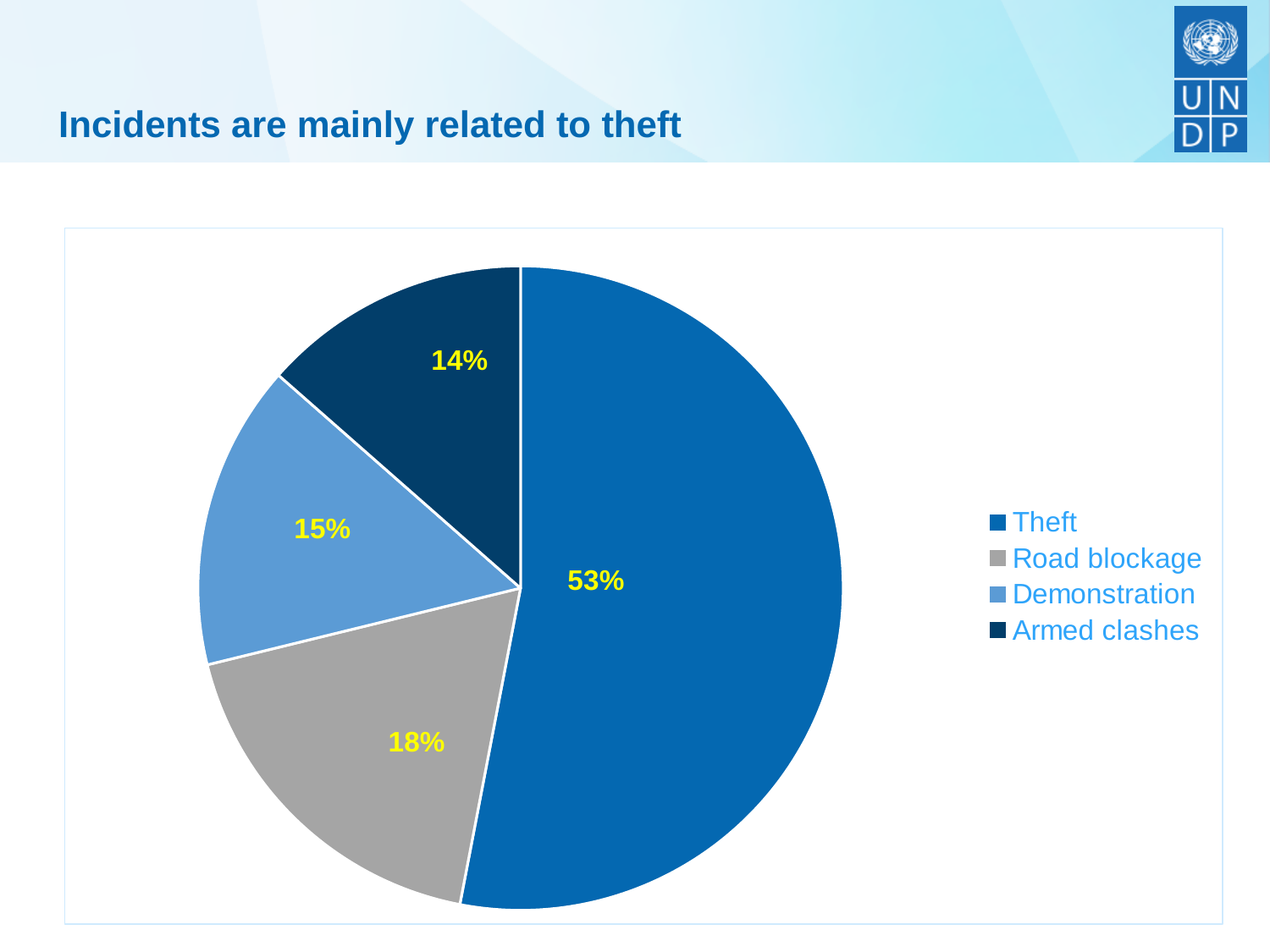
What share of incidents is Armed clashes? 14% Which category has the smallest share of the pie? Armed clashes What share of incidents is Theft? 53% Which is larger, the share for Road blockage or the share for Demonstration? Road blockage What share of incidents is Demonstration? 15% Which category is shown in the darkest blue colour? Armed clashes How many categories does the pie chart show? 4 Which category has the largest share of the pie? Theft What is the difference in percentage points between Theft and Road blockage? 35 What share of incidents is Road blockage? 18% What kind of chart is shown on the slide? Pie chart What is the title of the slide? Incidents are mainly related to theft